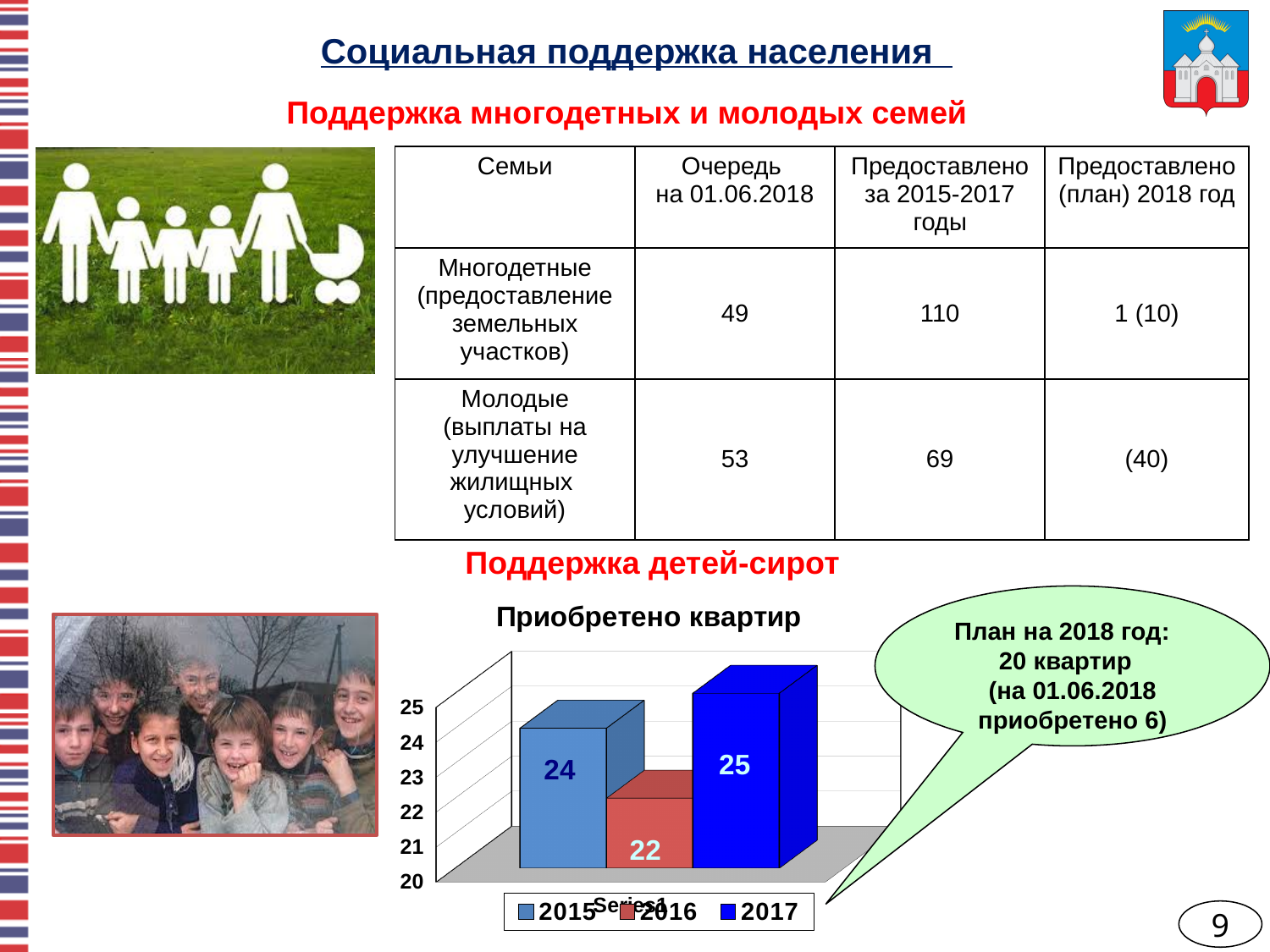
How many bars are plotted in the chart? 3 What type of chart is shown under "Приобретено квартир"? bar chart How many entries does the chart legend list? 3 What value does the chart show for 2016? 22 Is the value for 2016 greater or less than 23? less Which year has the lowest value in the chart? 2016 Which is larger, the value for 2015 or the value for 2016? 2015 What is the title of the chart on the slide? Приобретено квартир How many apartments were acquired in 2015 according to the chart? 24 What is the difference between the values for 2017 and 2016? 3 Which year has the highest value in the chart? 2017 What value does the chart show for 2017? 25